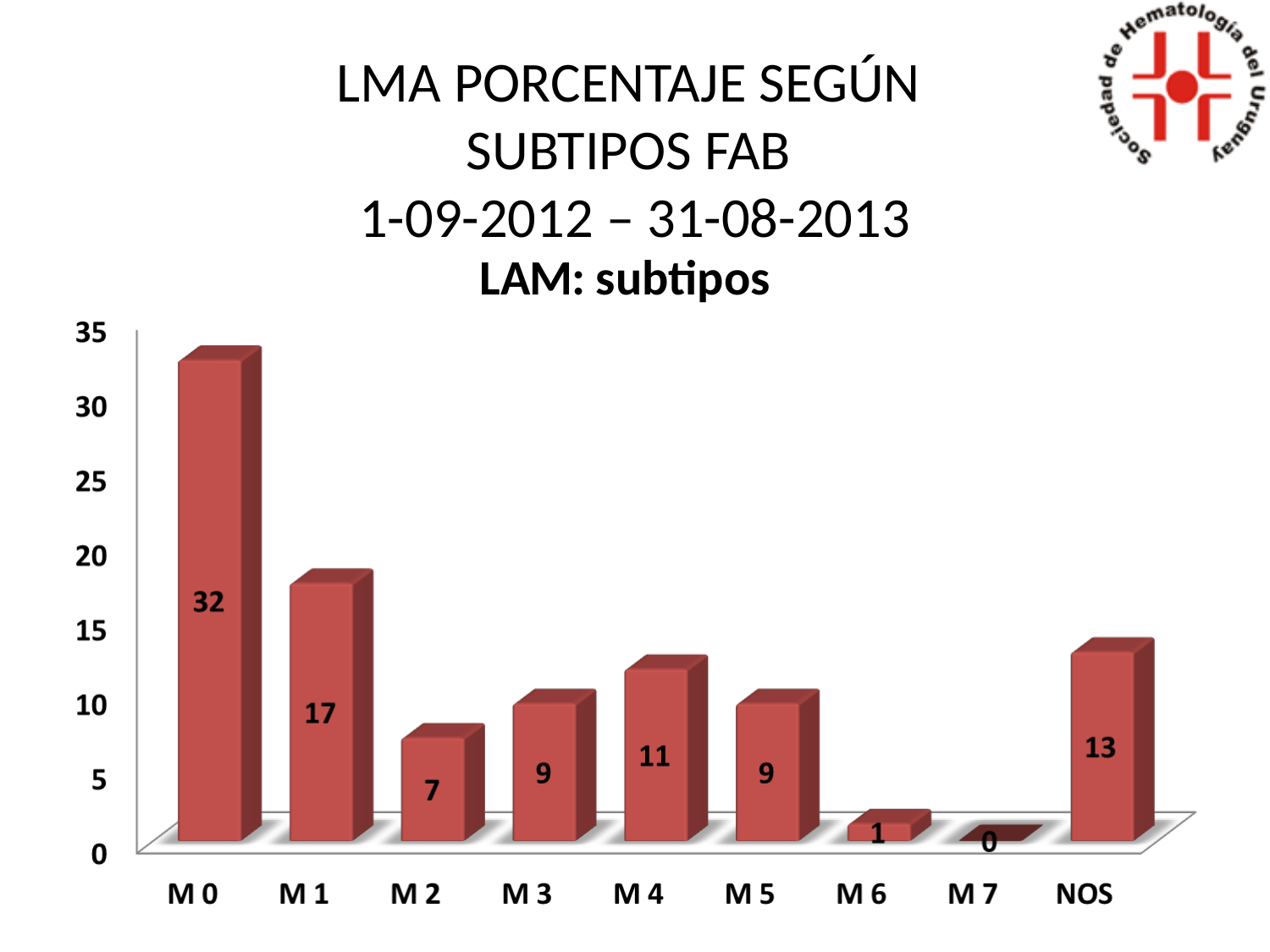
Which is larger, the value for M 1 or the value for NOS? M 1 Which category has the highest value? M 0 What kind of chart is shown on the slide? bar chart What is the value for M 0? 32 What is the value for NOS? 13 Is the value for M 0 greater or less than 30? greater What is the difference between the values for M 0 and M 1? 15 How many categories are shown on the x axis? 9 Which category has the lowest value? M 7 What is the difference between the values for NOS and M 2? 6 What is the value for M 4? 11 What is the title shown directly above the chart? LAM: subtipos